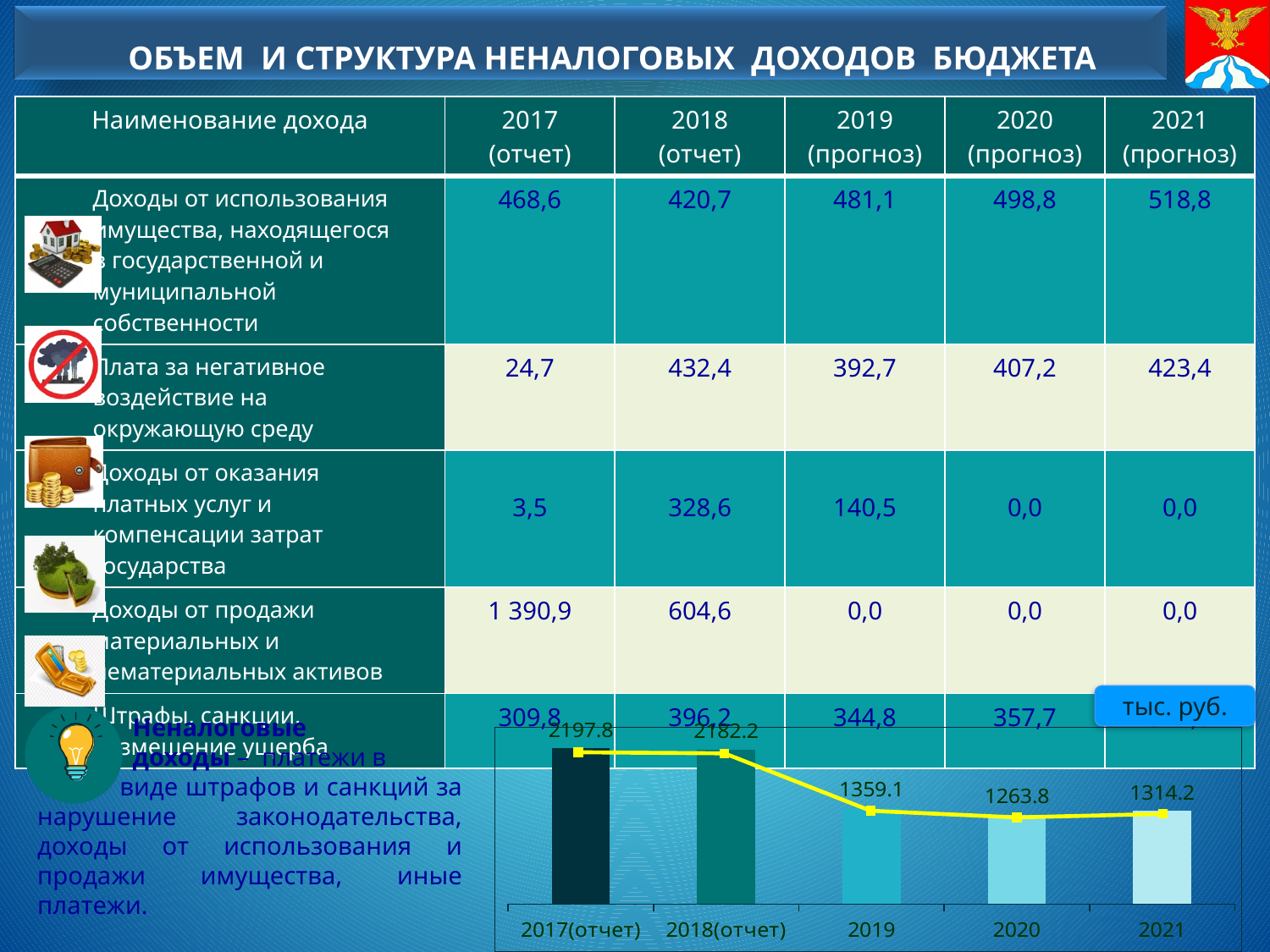
How many years (categories) are shown in the chart at the bottom of the slide? 5 In the chart at the bottom of the slide, what is the value for 2019? 1359.1 In the chart at the bottom of the slide, what is the difference between the values for 2018(отчет) and 2019? 823.1 In the chart at the bottom of the slide, which year has the highest value? 2017(отчет) In the chart at the bottom of the slide, what is the value for 2021? 1314.2 In the chart at the bottom of the slide, what is the value for 2018(отчет)? 2182.2 In the chart at the bottom of the slide, which is larger, the value for 2020 or the value for 2021? 2021 What unit is indicated for the chart at the bottom of the slide? тыс. руб. In the chart at the bottom of the slide, do the values rise or fall from 2017(отчет) to 2020? fall In the chart at the bottom of the slide, what is the difference between the values for 2019 and 2020? 95.3 In the chart at the bottom of the slide, what is the value for 2017(отчет)? 2197.8 In the chart at the bottom of the slide, which year has the lowest value? 2020